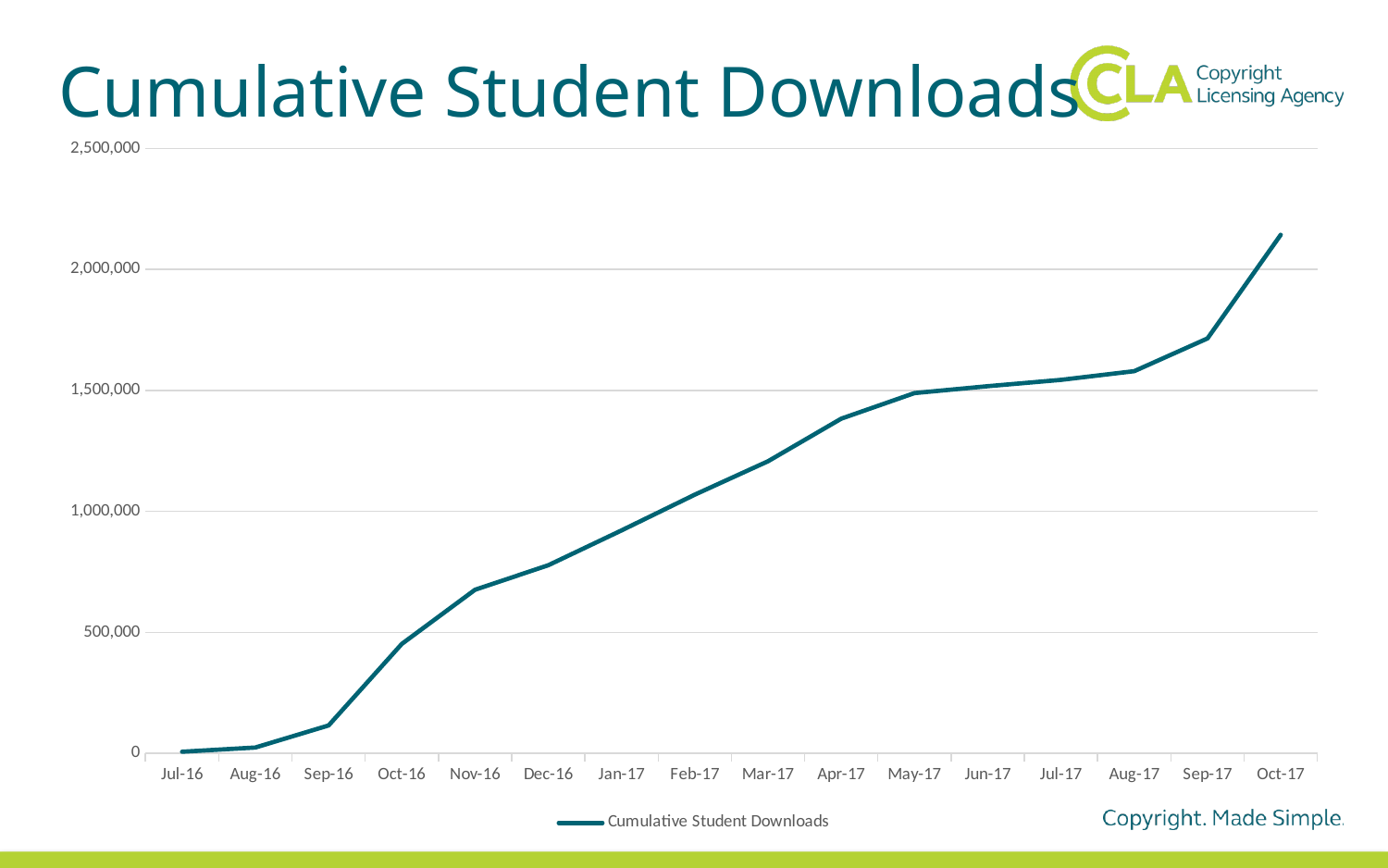
Which month has the lowest value for Cumulative Student Downloads? Jul-16 Do the values rise or fall from Jul-16 to Oct-17? rise What kind of chart is shown on the slide? line chart Is the value for Nov-16 greater or less than 500,000? greater How many months are plotted along the x axis? 16 Is the value for Oct-17 greater or less than 2,000,000? greater Which is larger, the value for Mar-17 or the value for Dec-16? Mar-17 How many series does the legend list? 1 Which month has the highest value for Cumulative Student Downloads? Oct-17 Is the value for Sep-17 greater or less than 1,500,000? greater What is the title of the chart? Cumulative Student Downloads